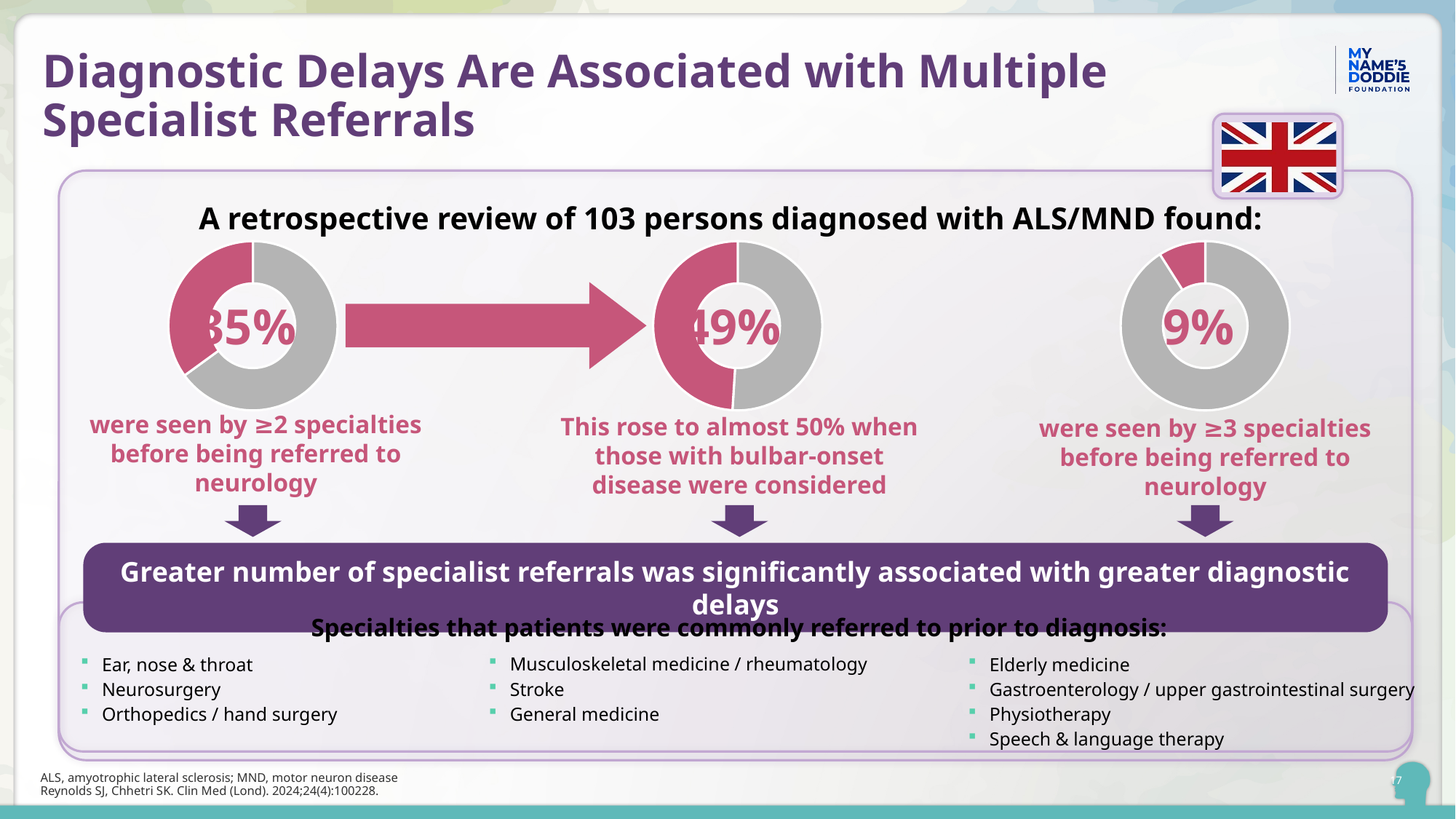
What colour is used for the highlighted segment in each donut chart? Pink/red How many donut charts are shown on the slide? 3 In the right donut chart, what share of the ring is highlighted in pink? 9% What kind of charts are used on this slide to show the percentages? Donut (pie) charts Which is larger: the percentage seen by ≥2 specialties (left chart) or the percentage seen by ≥3 specialties (right chart)? ≥2 specialties (left chart) By how many percentage points does the middle donut chart (49%) exceed the left donut chart (35%)? 14 percentage points Which of the three donut charts shows the lowest percentage? The right one (9%) What is the difference between the left donut chart (35%) and the right donut chart (9%)? 26 percentage points What percentage is shown in the left donut chart (persons seen by ≥2 specialties before being referred to neurology)? 35% What percentage is shown in the right donut chart (persons seen by ≥3 specialties before being referred to neurology)? 9% What percentage is shown in the middle donut chart (when those with bulbar-onset disease were considered)? 49% Which of the three donut charts shows the highest percentage? The middle one (49%)